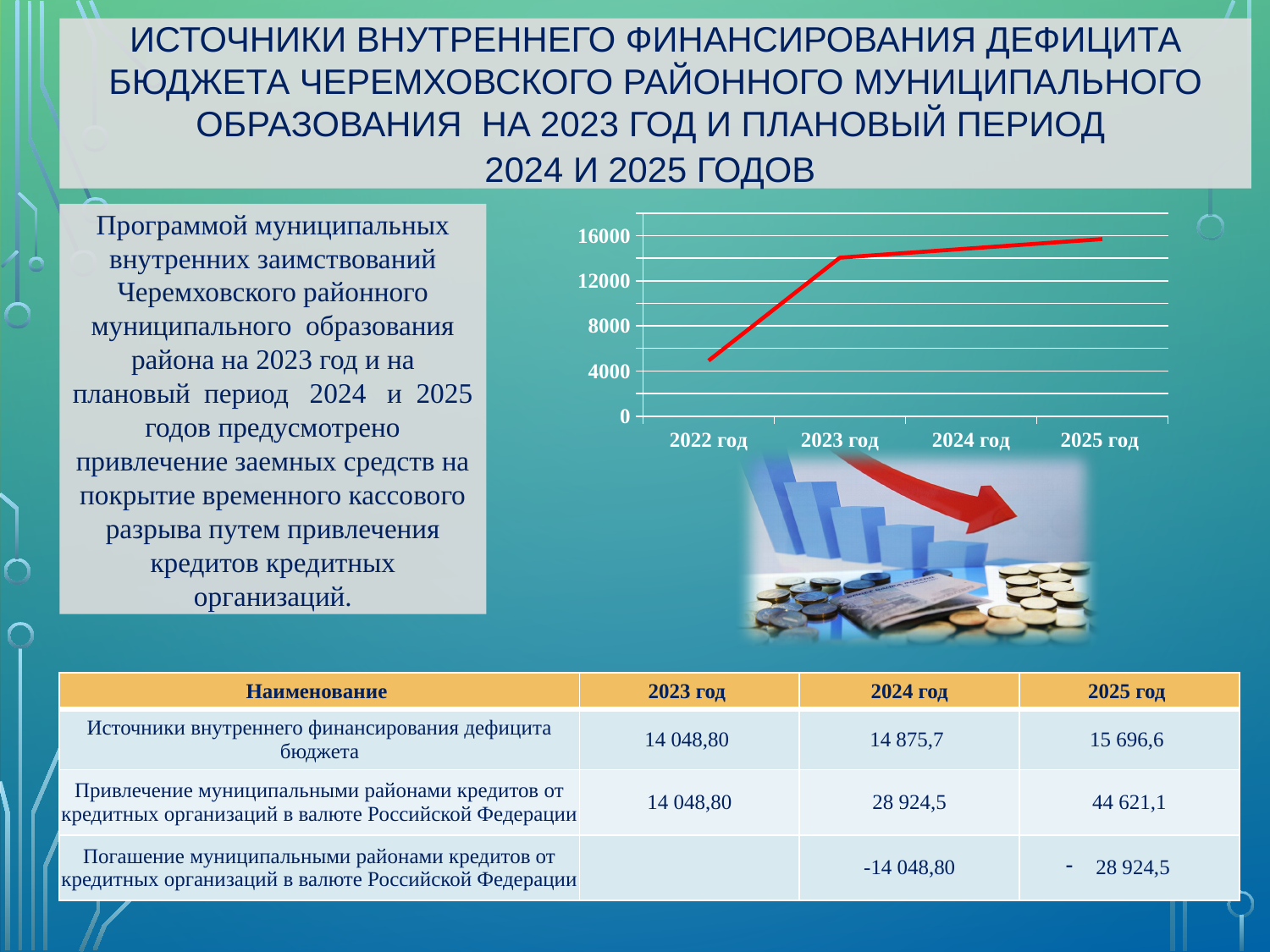
Which is larger on the line chart, the value for 2022 год or the value for 2023 год? 2023 год What colour is the line on the chart? red Which year has the lowest value on the line chart? 2022 год Is the value for 2024 год greater or less than 12000? greater How many data points are plotted on the line chart? 4 What is the highest tick value shown on the vertical axis of the chart? 16000 Do the values on the line chart rise or fall from 2022 год to 2025 год? rise Is the value for 2023 год greater or less than 12000? greater Is the value for 2022 год greater or less than 4000? greater Which year has the highest value on the line chart? 2025 год What kind of chart is shown on the slide? line chart